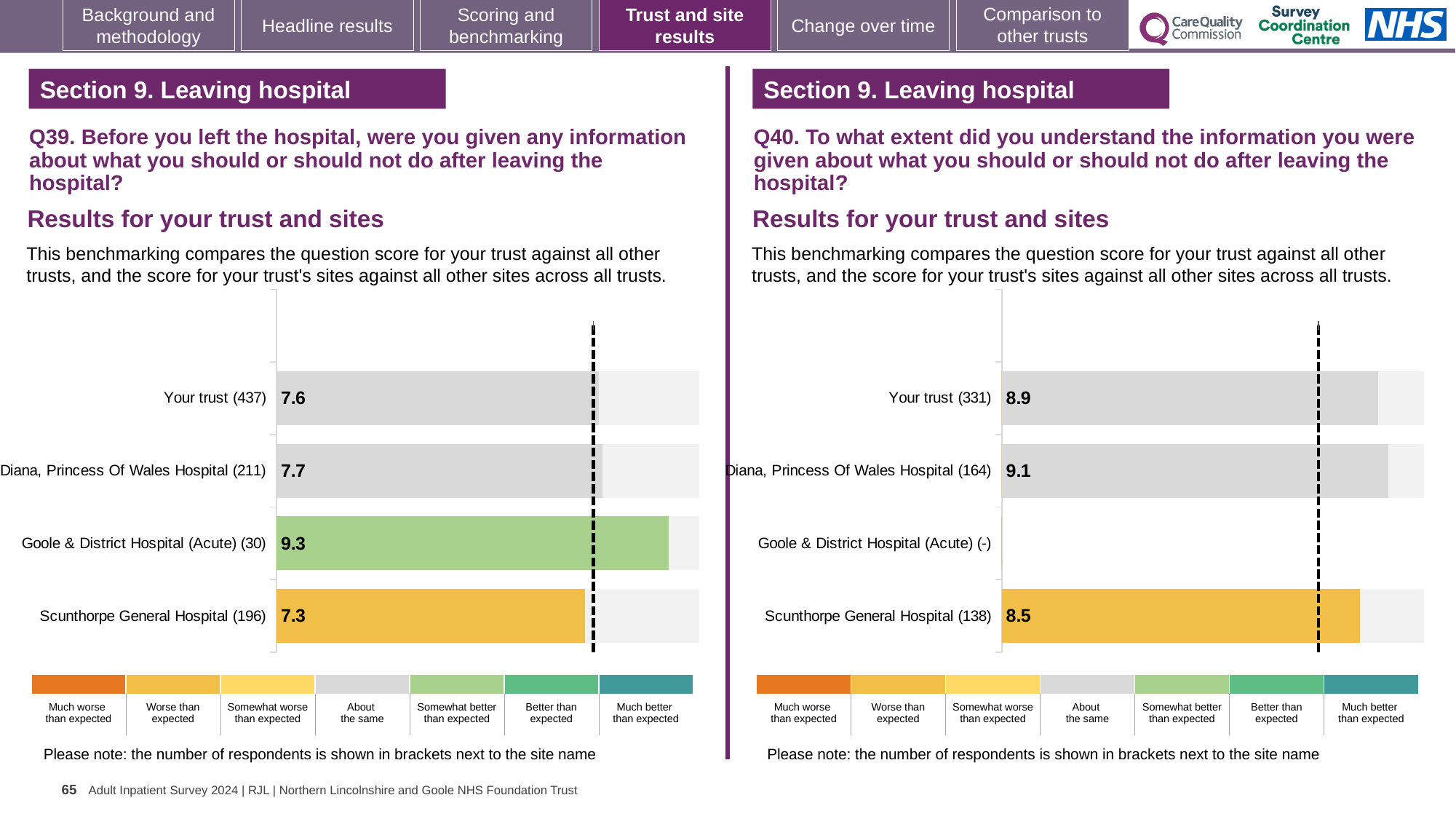
In the Q40 chart on the right, what is the score for Scunthorpe General Hospital? 8.5 In the Q40 chart on the right, what is the difference between the scores for Diana, Princess Of Wales Hospital and Your trust? 0.2 What kind of chart is used on the left for Q39? Bar chart In the Q39 chart on the left, which site has the lowest score? Scunthorpe General Hospital In the Q39 chart on the left, what is the difference between the scores for Goole & District Hospital (Acute) and Scunthorpe General Hospital? 2.0 In the Q39 chart on the left, how many respondents are shown in brackets for Your trust? 437 In the Q40 chart on the right, which of the sites with a score shown has the lowest score? Scunthorpe General Hospital In the Q40 chart on the right, which has the higher score: Your trust or Scunthorpe General Hospital? Your trust In the Q39 chart on the left, what is the score for Your trust? 7.6 In the Q39 chart on the left, what is the score for Goole & District Hospital (Acute)? 9.3 In the Q39 chart on the left, which site has the highest score? Goole & District Hospital (Acute) In the Q40 chart on the right, what is the score for Diana, Princess Of Wales Hospital? 9.1